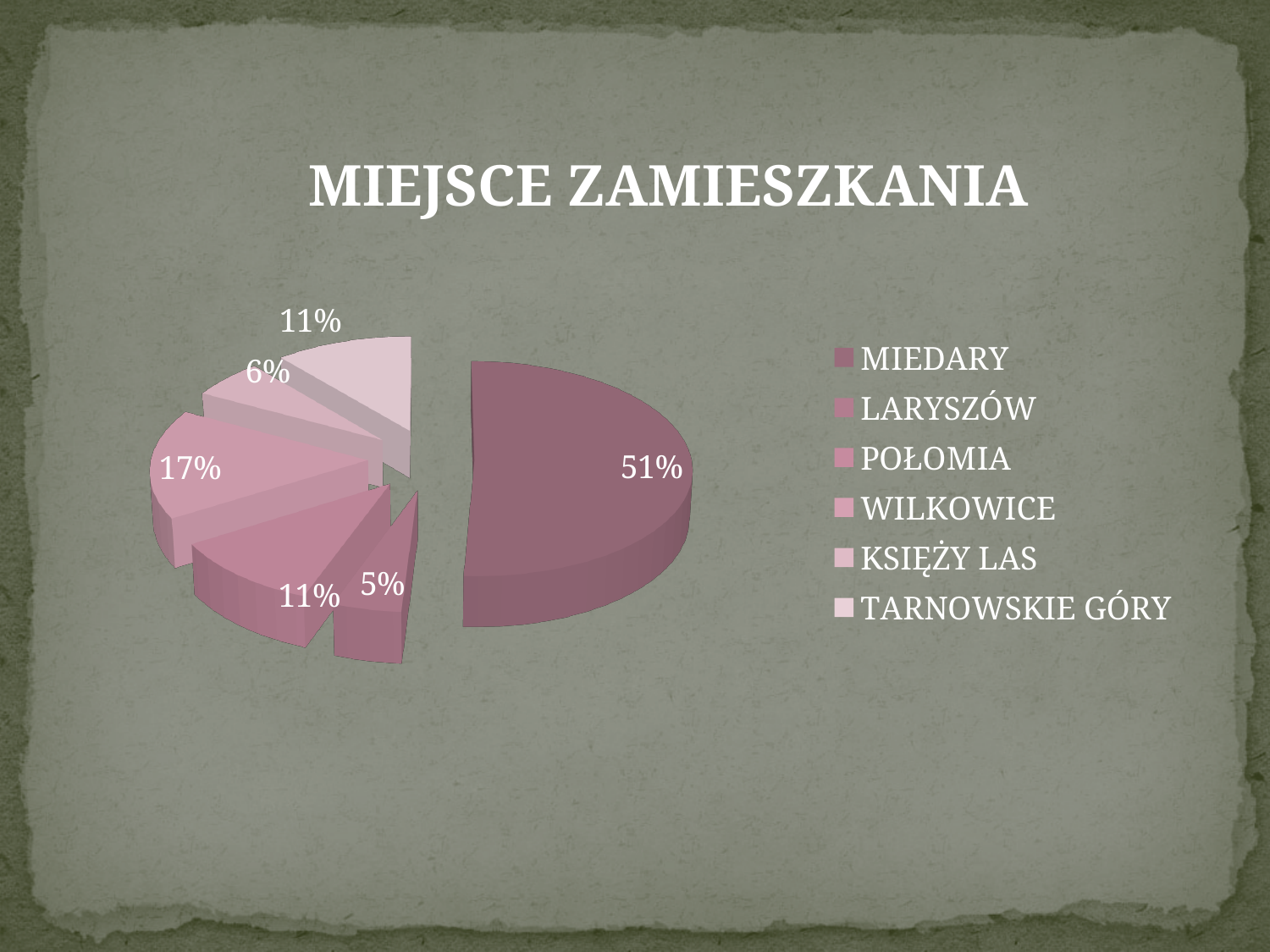
Which category has the largest share of the pie? MIEDARY How many categories does the legend list? 6 What kind of chart is shown on the slide? pie chart Which has a larger share, WILKOWICE or KSIĘŻY LAS? WILKOWICE Which category has the smallest share of the pie? LARYSZÓW What share of the pie does TARNOWSKIE GÓRY have? 11% What share of the pie does LARYSZÓW have? 5% What share of the pie does KSIĘŻY LAS have? 6% What share of the pie does WILKOWICE have? 17% What is the difference between the shares of MIEDARY and WILKOWICE? 34% What is the title of the chart? MIEJSCE ZAMIESZKANIA What share of the pie does MIEDARY have? 51%